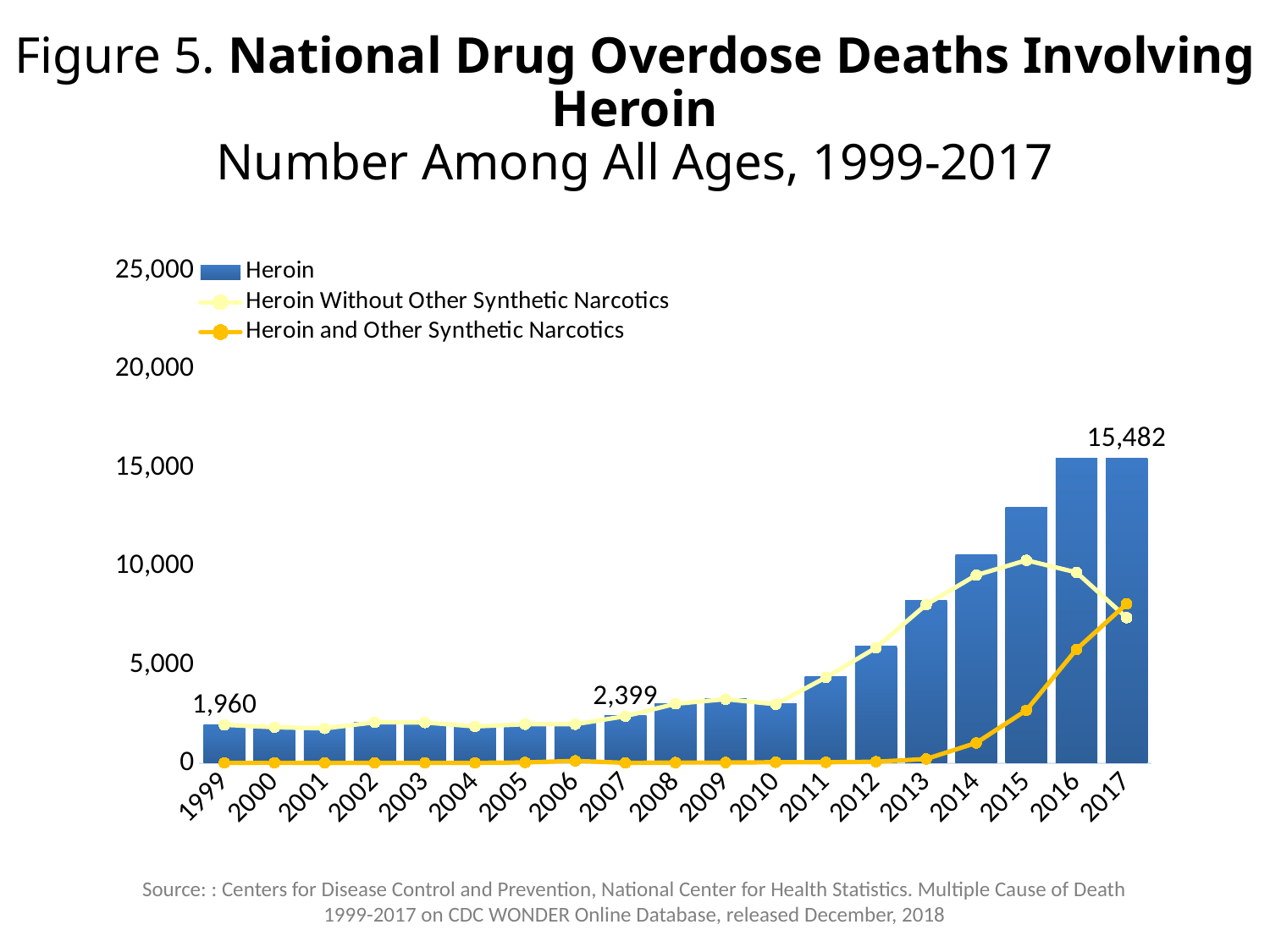
Is the Heroin bar for 2015 greater or less than 10,000? greater How many years are shown on the x axis? 19 How many series does the legend list? 3 What is the difference between the labelled Heroin values for 2007 and 1999? 439 How much higher is the labelled Heroin value for 2017 than for 1999? 13,522 Is the Heroin bar for 2013 greater or less than 10,000? less Is the Heroin and Other Synthetic Narcotics value for 2017 greater or less than 5,000? greater Does the Heroin and Other Synthetic Narcotics line rise or fall from 2013 to 2017? rise In 2016, which series is higher: Heroin Without Other Synthetic Narcotics or Heroin and Other Synthetic Narcotics? Heroin Without Other Synthetic Narcotics What is the number of heroin overdose deaths shown for 2017? 15,482 What is the number of heroin overdose deaths shown for 2007? 2,399 What is the number of heroin overdose deaths shown for 1999? 1,960